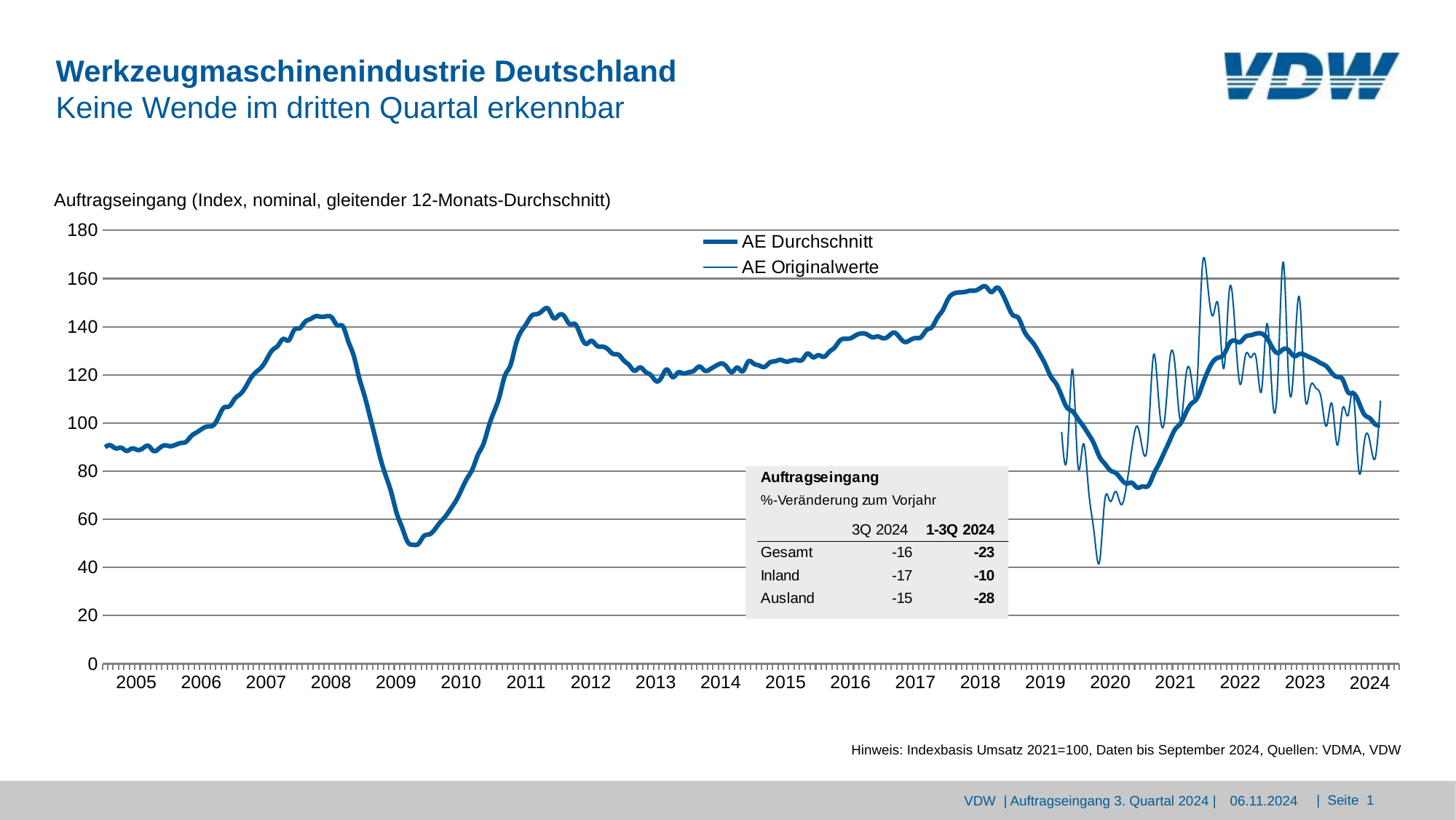
What is the title printed above the chart? Auftragseingang (Index, nominal, gleitender 12-Monats-Durchschnitt) How many series does the chart legend list? 2 How many year labels are shown on the x axis? 20 Is the lowest value of AE Durchschnitt in 2009 greater or less than 60? less Does AE Durchschnitt rise or fall between 2009 and 2011? rise Is the lowest value of AE Durchschnitt in 2020 greater or less than 80? less What are the two series named in the chart legend? AE Durchschnitt and AE Originalwerte Is the peak value of AE Durchschnitt in 2018 greater or less than 140? greater Which is higher for AE Durchschnitt: the peak in 2018 or the peak in 2008? the peak in 2018 Does AE Durchschnitt rise or fall between 2018 and 2020? fall What kind of chart is shown on the slide? line chart